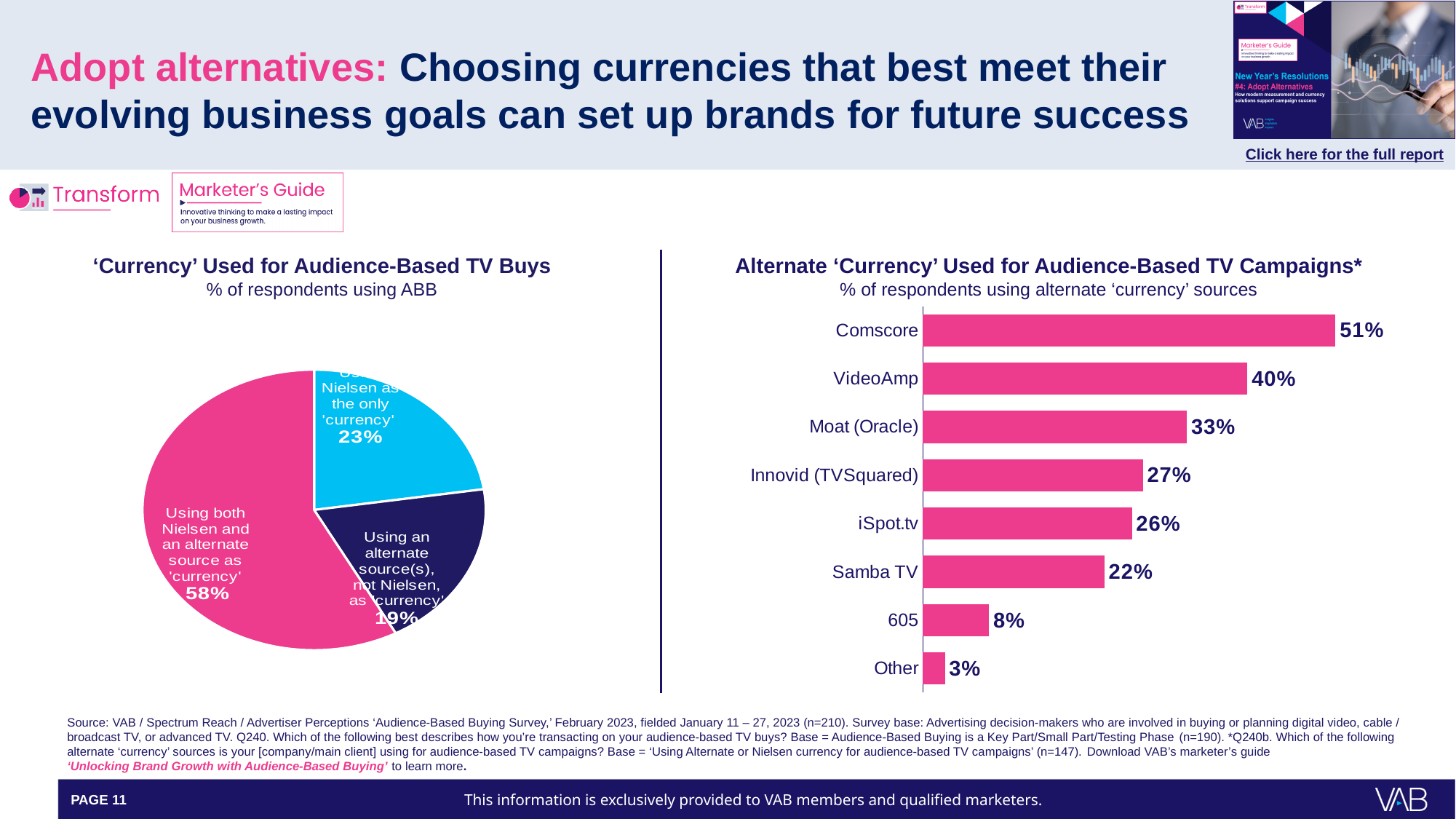
What kind of chart is the 'Currency Used for Audience-Based TV Buys' chart? Pie chart In the 'Currency Used for Audience-Based TV Buys' chart, what share of respondents are using both Nielsen and an alternate source as 'currency'? 58% In the 'Alternate Currency Used for Audience-Based TV Campaigns' chart, which alternate currency source has the highest percentage? Comscore In the 'Alternate Currency Used for Audience-Based TV Campaigns' chart, which category has the lowest percentage? Other In the 'Currency Used for Audience-Based TV Buys' chart, what percentage of respondents are using an alternate source(s), not Nielsen, as 'currency'? 19% What is the subtitle of the 'Alternate Currency Used for Audience-Based TV Campaigns' chart? % of respondents using alternate 'currency' sources In the 'Alternate Currency Used for Audience-Based TV Campaigns' chart, which is larger: the value for iSpot.tv or the value for 605? iSpot.tv In the 'Alternate Currency Used for Audience-Based TV Campaigns' chart, what is the value for Samba TV? 22% How many categories are shown in the 'Alternate Currency Used for Audience-Based TV Campaigns' chart? 8 In the 'Alternate Currency Used for Audience-Based TV Campaigns' chart, what is the difference between the values for VideoAmp and Moat (Oracle)? 7% What kind of chart is the 'Alternate Currency Used for Audience-Based TV Campaigns' chart? Bar chart In the 'Alternate Currency Used for Audience-Based TV Campaigns' chart, what percentage of respondents use Comscore? 51%